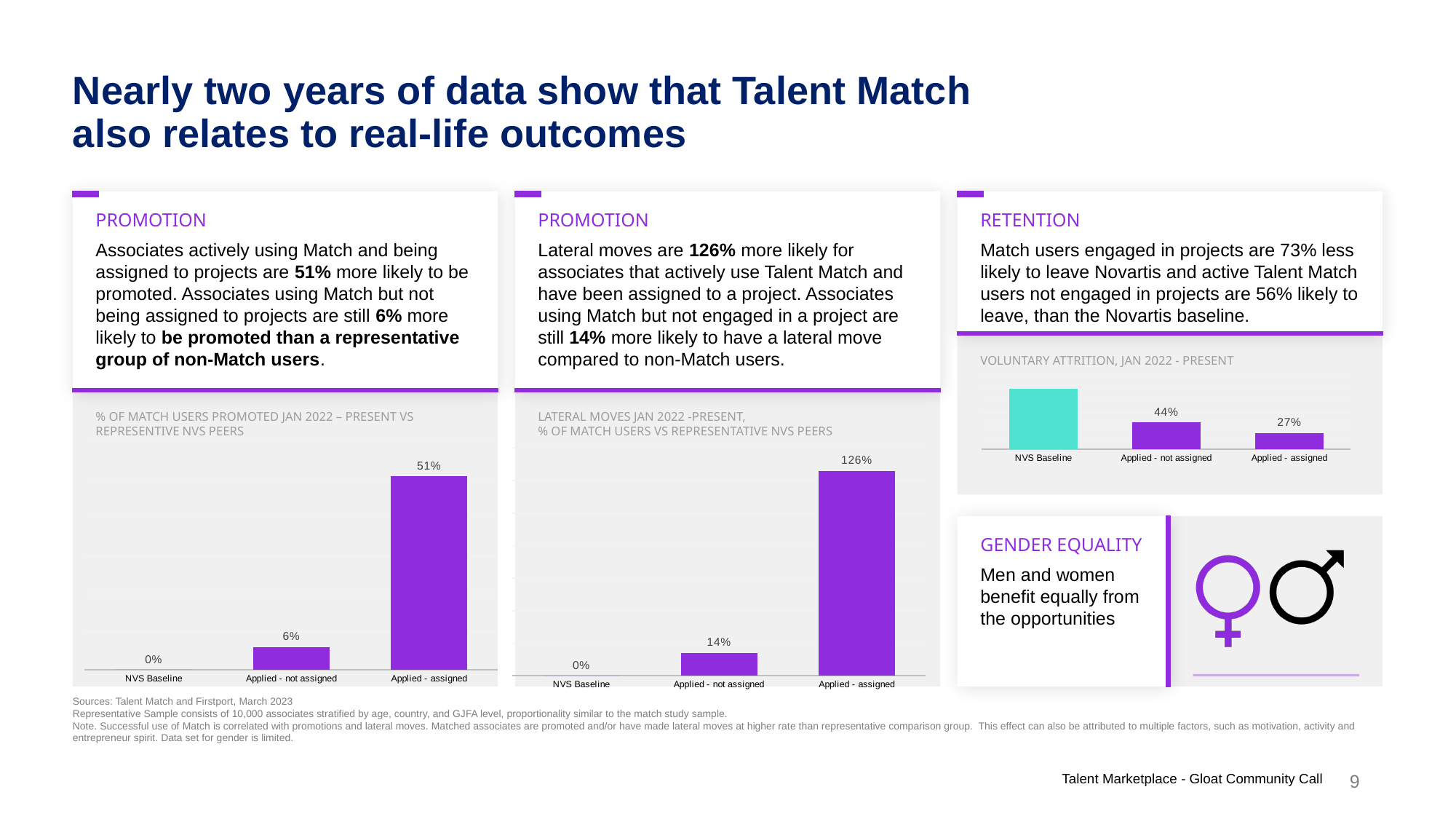
In the '% of Match users promoted' chart on the left, what is the value for 'Applied - assigned'? 51% In the 'Lateral moves' chart in the middle, what is the difference between 'Applied - assigned' and 'Applied - not assigned'? 112% In the '% of Match users promoted' chart on the left, what is the value for 'Applied - not assigned'? 6% In the 'Voluntary attrition' chart on the right, what is the value for 'Applied - not assigned'? 44% What kind of chart is the 'Voluntary attrition' chart on the right? Bar chart In the 'Voluntary attrition' chart on the right, which category has the highest bar? NVS Baseline In the 'Voluntary attrition' chart on the right, what is the value for 'Applied - assigned'? 27% In the 'Lateral moves' chart in the middle, what is the value for 'Applied - assigned'? 126% In the '% of Match users promoted' chart on the left, what is the difference between 'Applied - assigned' and 'Applied - not assigned'? 45% In the '% of Match users promoted' chart on the left, how many categories are shown on the x axis? 3 In the 'Lateral moves' chart in the middle, which category has the lowest value? NVS Baseline In the 'Lateral moves' chart in the middle, what is the value for 'Applied - not assigned'? 14%